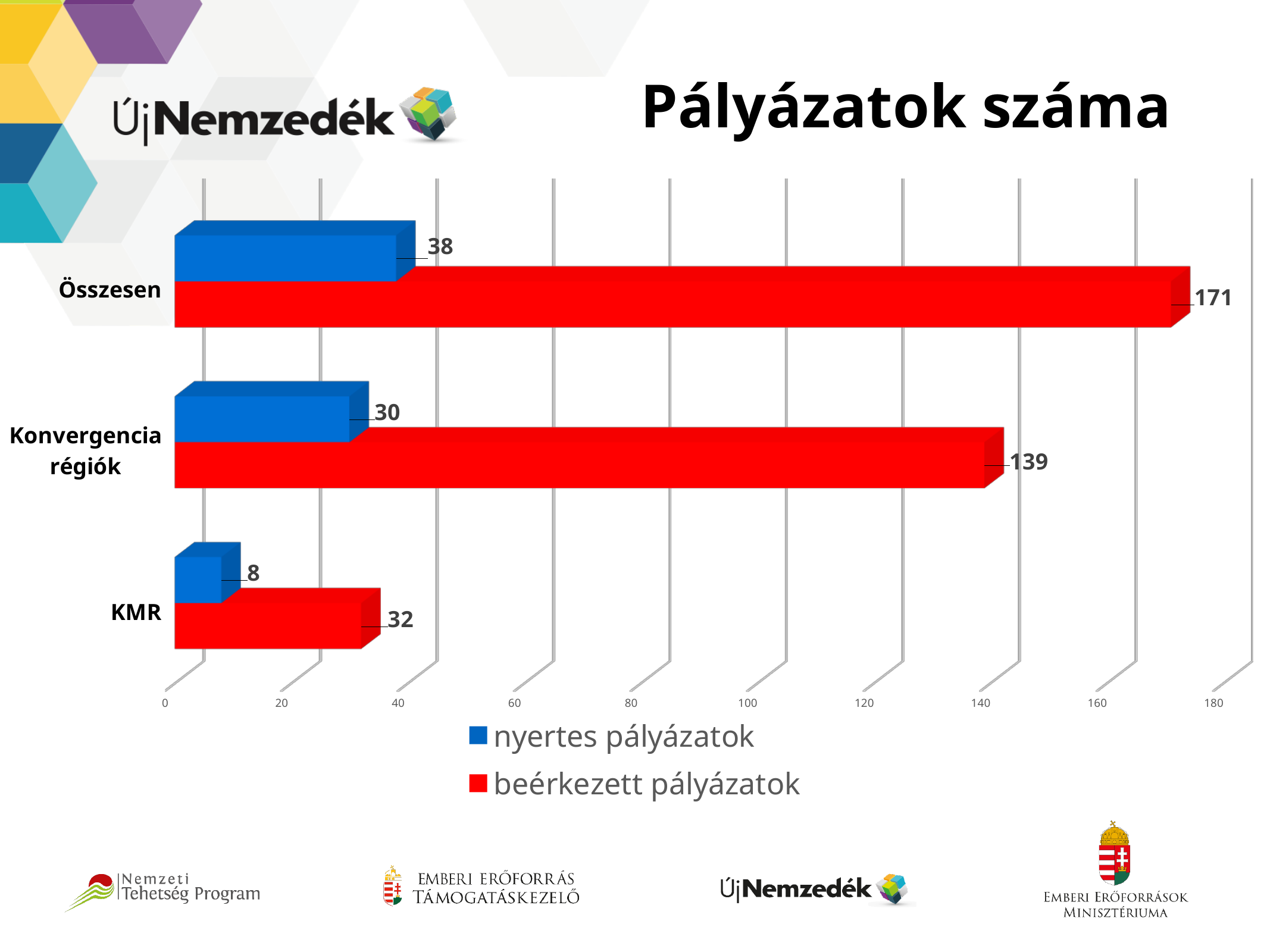
How many categories are shown on the chart? 3 What kind of chart is shown on the slide? bar chart What is the value of nyertes pályázatok for KMR? 8 What is the value of beérkezett pályázatok for Összesen? 171 What is the difference between beérkezett pályázatok and nyertes pályázatok for Konvergencia régiók? 109 What is the value of beérkezett pályázatok for KMR? 32 What is the title of the chart? Pályázatok száma Which is larger for KMR: nyertes pályázatok or beérkezett pályázatok? beérkezett pályázatok Which category has the lowest value for nyertes pályázatok? KMR What is the value of nyertes pályázatok for Konvergencia régiók? 30 How many series does the legend list? 2 Which category has the highest value for beérkezett pályázatok? Összesen